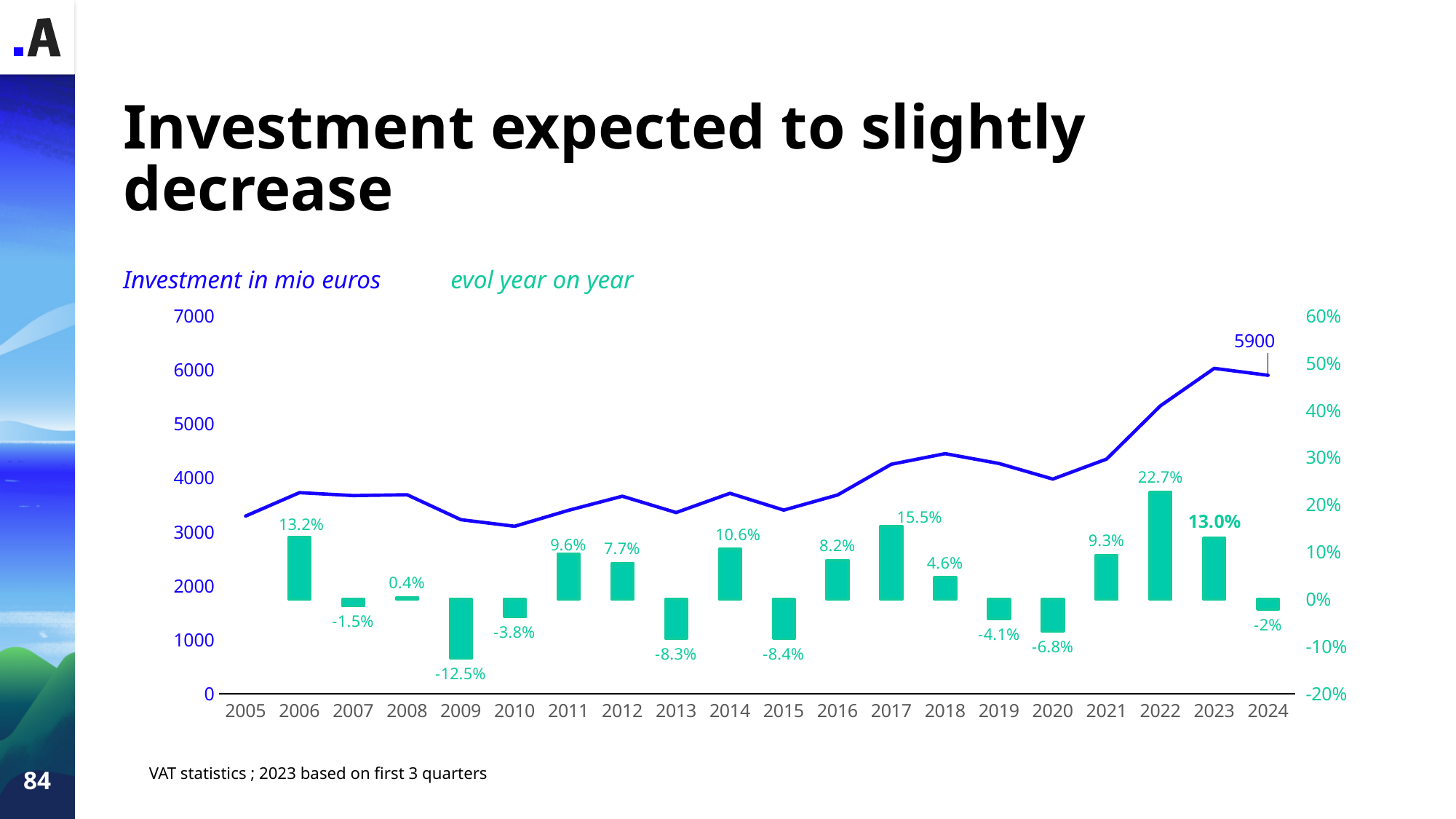
What is the difference between the year-on-year evolution values for 2022 and 2023? 9.7 percentage points Is the investment value on the line for 2022 greater or less than 5000? greater Is the investment value on the line for 2005 greater or less than 4000? less Which year has a larger year-on-year evolution value, 2014 or 2017? 2017 What is the year-on-year evolution value shown for 2022? 22.7% Which year has the lowest year-on-year evolution bar? 2009 What investment value in mio euros is labelled on the line for 2024? 5900 What is the year-on-year evolution value shown for 2009? -12.5% What kind of chart is used to show the year-on-year evolution? Bar chart How many years are shown on the x axis? 20 Does the investment line rise or fall from 2020 to 2023? Rise Which year has the highest year-on-year evolution bar? 2022